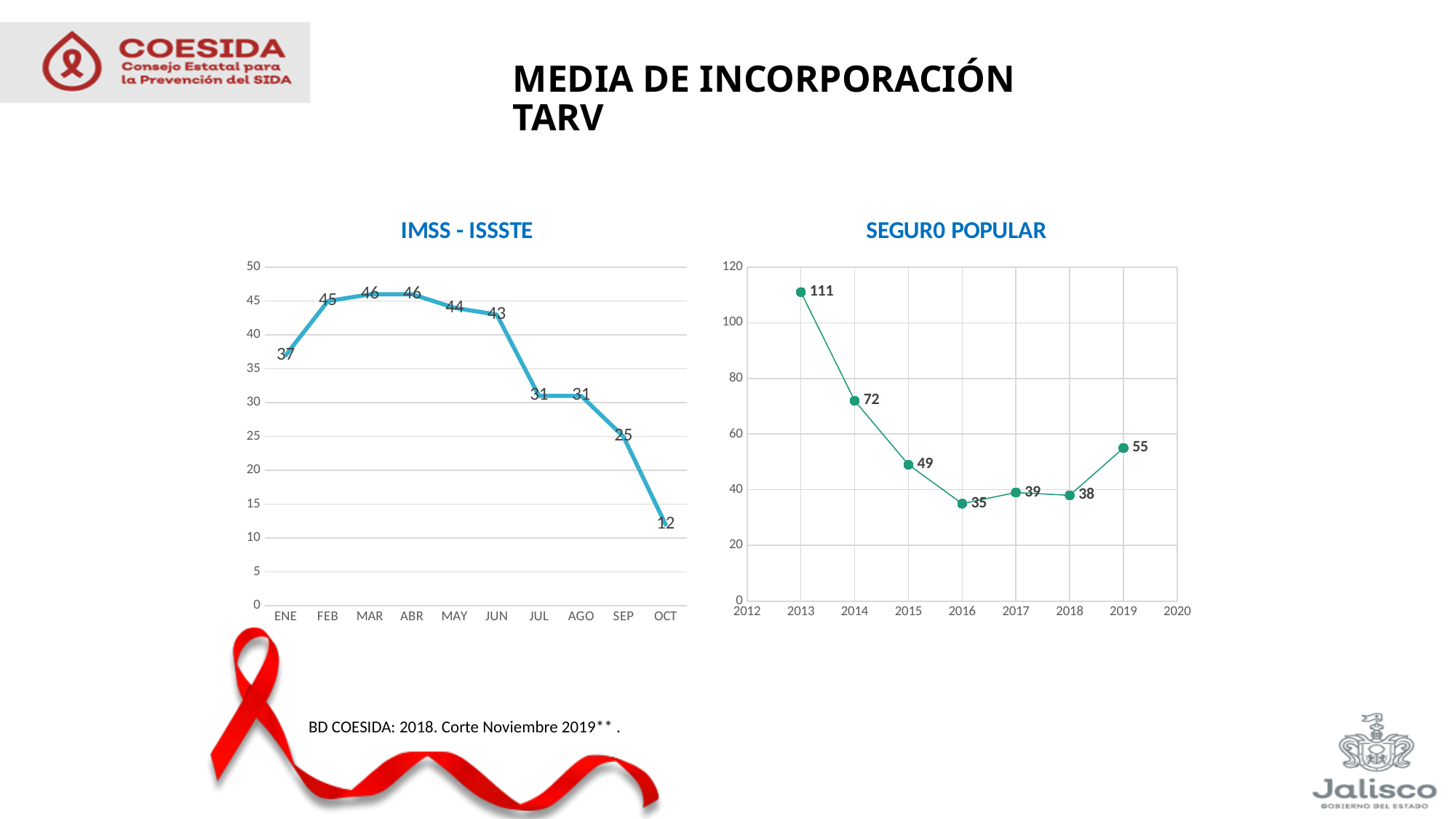
In the IMSS - ISSSTE chart, what is the difference between the values for FEB and SEP? 20 In the IMSS - ISSSTE chart, which month has the lowest value? OCT In the SEGUR0 POPULAR chart, which year has the lowest value? 2016 What kind of chart is the SEGUR0 POPULAR chart? line chart In the IMSS - ISSSTE chart, is the value for ENE greater or less than 35? greater In the SEGUR0 POPULAR chart, which is larger, the value for 2019 or the value for 2017? 2019 In the IMSS - ISSSTE chart, what is the value for JUN? 43 In the SEGUR0 POPULAR chart, which year has the highest value? 2013 In the SEGUR0 POPULAR chart, what is the value for 2015? 49 In the IMSS - ISSSTE chart, how many months are plotted on the x axis? 10 In the IMSS - ISSSTE chart, do the values rise or fall from JUN to OCT? fall In the SEGUR0 POPULAR chart, what is the difference between the values for 2013 and 2014? 39